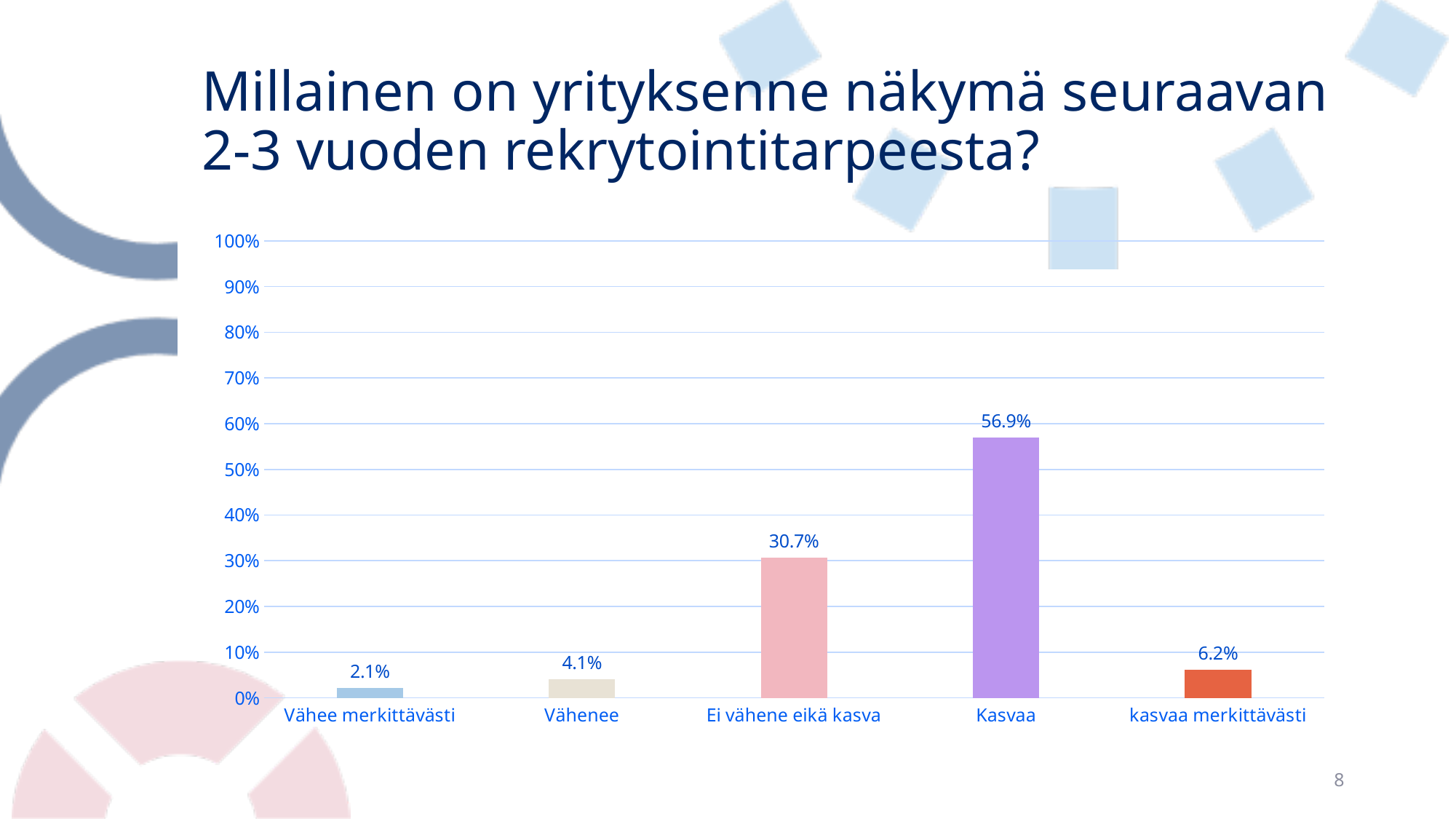
What is the value for Vähee merkittävästi? 2.1% What is the difference between the values for Kasvaa and Ei vähene eikä kasva? 26.2% Which is larger, the value for Vähenee or the value for kasvaa merkittävästi? kasvaa merkittävästi Which category has the lowest value? Vähee merkittävästi What is the value for Kasvaa? 56.9% Is the value for Kasvaa greater or less than 50%? greater What is the value for kasvaa merkittävästi? 6.2% What is the title of the slide? Millainen on yrityksenne näkymä seuraavan 2-3 vuoden rekrytointitarpeesta? Which category has the highest value? Kasvaa What kind of chart is shown on the slide? bar chart What is the value for Ei vähene eikä kasva? 30.7% How many categories are shown on the x axis? 5